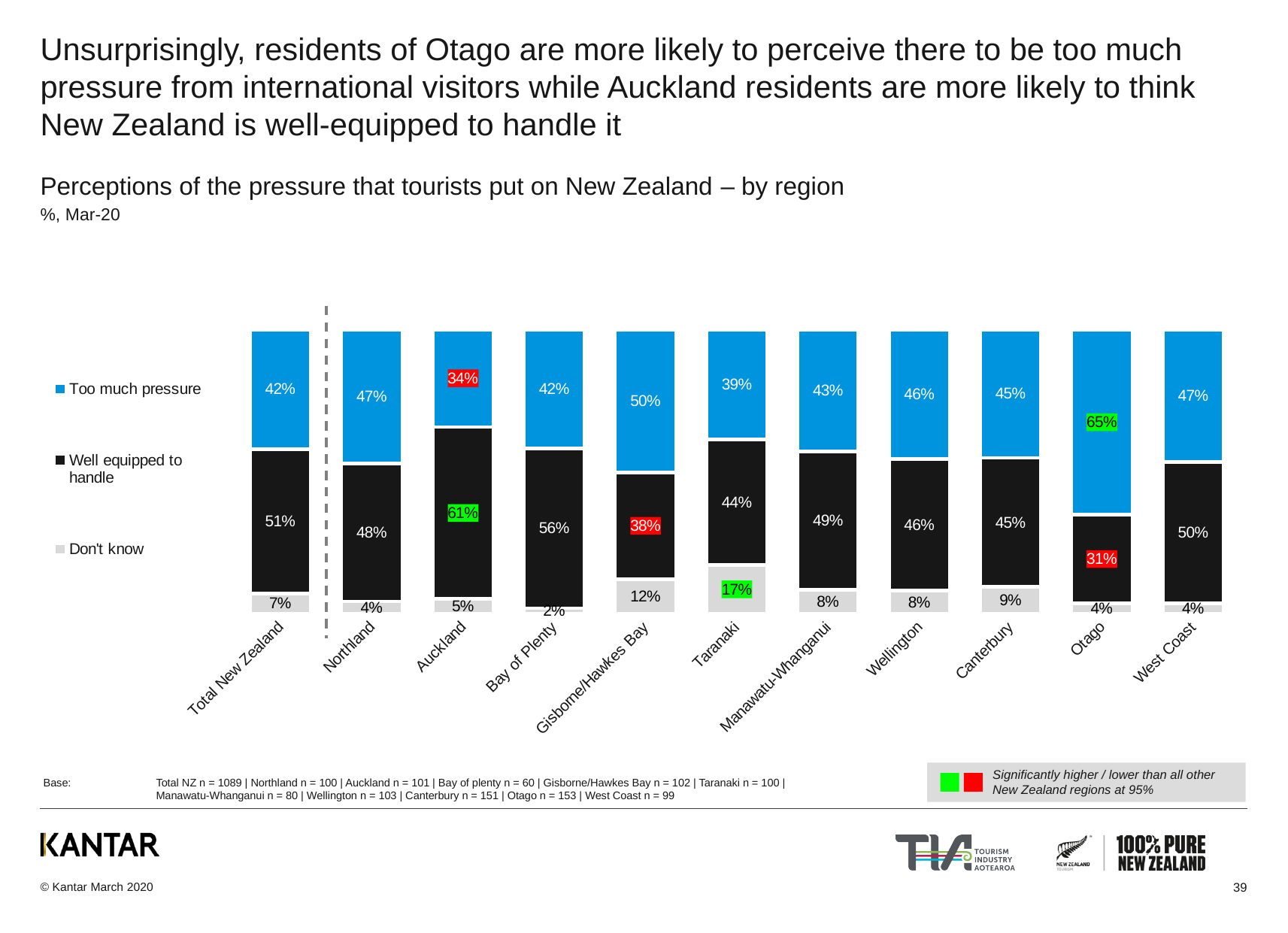
Which region has the lowest 'Don't know' value? Bay of Plenty What percentage of Otago residents say there is too much pressure? 65% How many regions (including Total New Zealand) are shown on the x axis? 11 What is the difference between the 'Too much pressure' values for Otago and Auckland? 31 percentage points What is the 'Don't know' value for Taranaki? 17% What kind of chart is shown on the slide? Stacked bar chart Which region has the highest 'Too much pressure' value? Otago What is the 'Too much pressure' value for Total New Zealand? 42% Is the 'Well equipped to handle' value larger for Gisborne/Hawkes Bay or for Taranaki? Taranaki Which region has the lowest 'Well equipped to handle' value? Otago How many series does the legend list? 3 What is the 'Well equipped to handle' value for Auckland? 61%